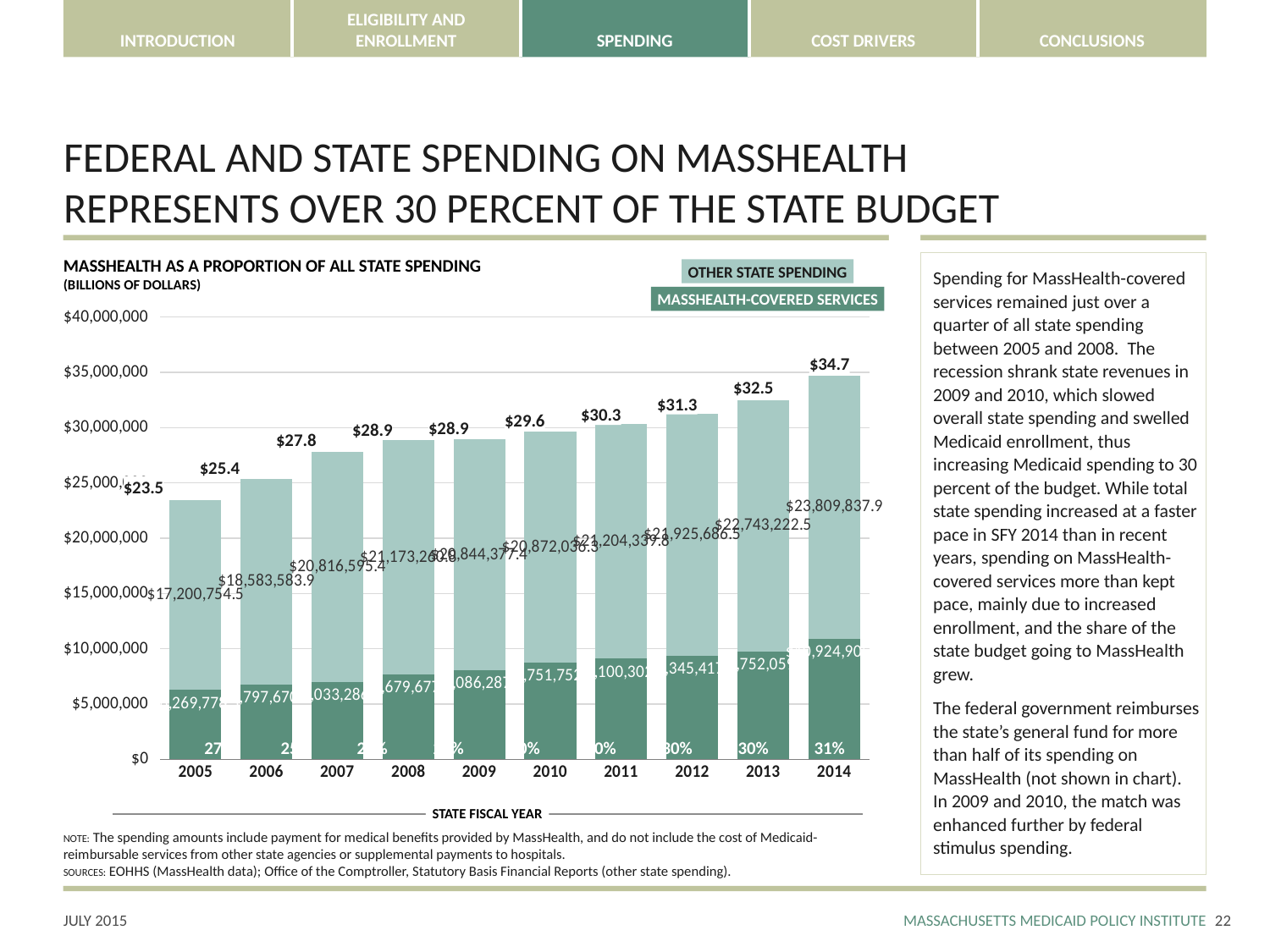
How many state fiscal years are shown on the x axis? 10 What type of chart is shown on the slide? Stacked bar chart Which state fiscal year has the highest total bar? 2014 What is the Other State Spending value labeled for 2014? $23,809,837.9 What percentage is labeled at the bottom of the 2014 bar? 31% How many series does the legend list? 2 What is the difference between the total labels for 2014 and 2005? $11.2 Which state fiscal year has the lowest total bar? 2005 Do the total bar values rise or fall from 2005 to 2014? Rise Which year has the larger total bar, 2010 or 2011? 2011 What is the total labeled above the bar for 2014? $34.7 What is the total labeled above the bar for 2005? $23.5